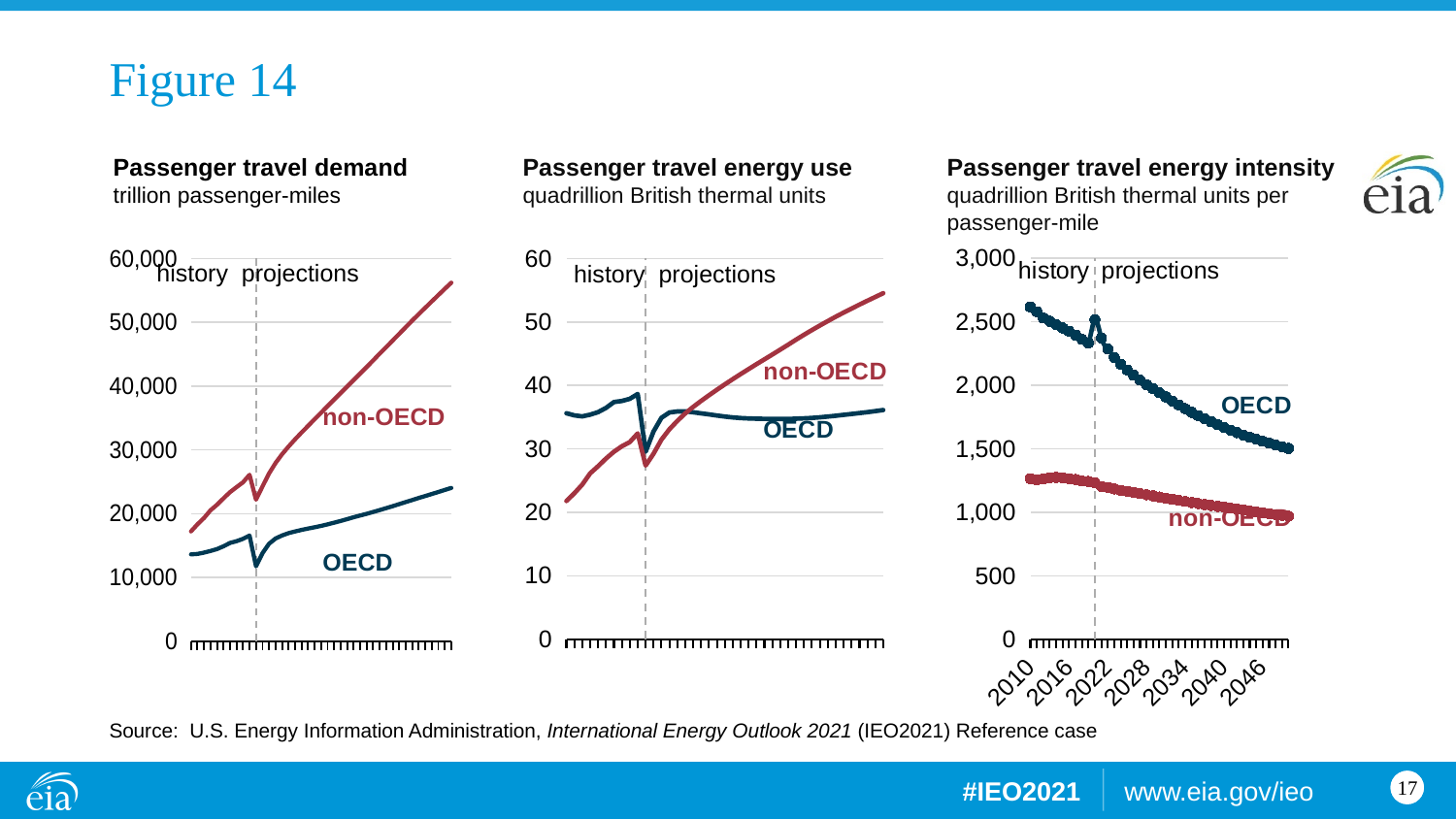
How many series are plotted in the Passenger travel energy use chart? 2 In the Passenger travel energy intensity chart, does the OECD line rise or fall from 2010 to 2046? fall In the Passenger travel energy use chart, is the non-OECD value at the end of the projection period greater or less than 50? greater What type of chart is the Passenger travel demand chart? line chart What two periods does the dashed vertical line separate in each chart? history and projections In the Passenger travel demand chart, is the non-OECD value at the end of the projection period greater or less than 50,000? greater What unit is used on the Passenger travel demand chart? trillion passenger-miles In the Passenger travel energy use chart, which series is higher at the end of the projection period, OECD or non-OECD? non-OECD In the Passenger travel energy intensity chart, which series is higher throughout, OECD or non-OECD? OECD In the Passenger travel demand chart, is the OECD value at the end of the projection period greater or less than 30,000? less In the Passenger travel demand chart, does the non-OECD line rise or fall over the projection period? rise